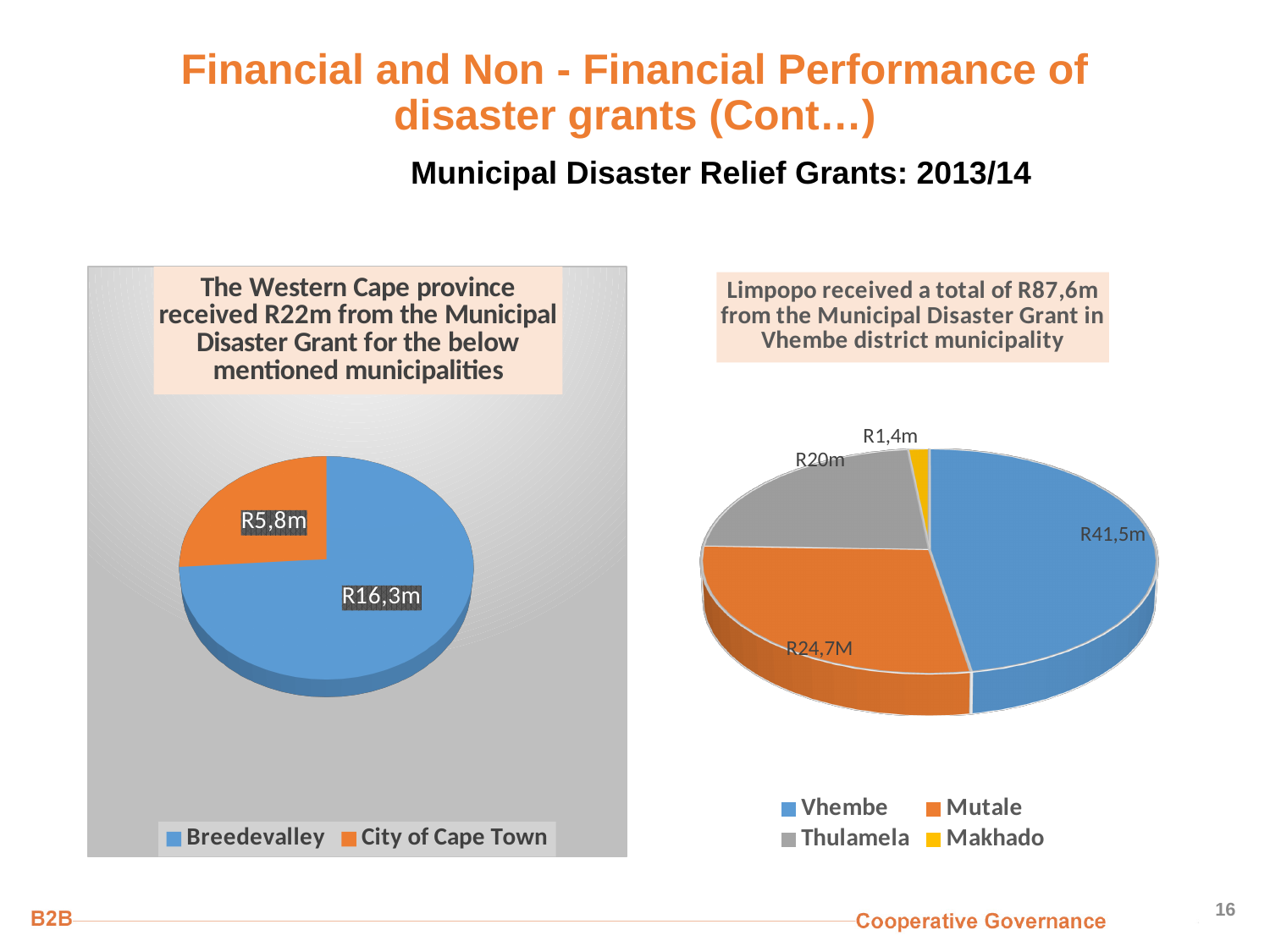
On the right chart (Limpopo), which colour represents Makhado in the legend? Yellow On the right chart (Limpopo), what value is shown for Vhembe? R41,5m On the right chart (Limpopo), which municipality received the largest amount? Vhembe On the left chart (Western Cape), what is the difference between the Breedevalley and City of Cape Town values? R10,5m On the right chart (Limpopo), what is the difference between the Vhembe and Mutale values? R16,8m On the left chart (Western Cape), what value is shown for Breedevalley? R16,3m What type of chart is the left chart (Western Cape)? Pie chart On the left chart (Western Cape), what value is shown for City of Cape Town? R5,8m On the right chart (Limpopo), which is larger, Mutale or Thulamela? Mutale On the right chart (Limpopo), what value is shown for Thulamela? R20m How many slices does the right chart (Limpopo) have? 4 On the right chart (Limpopo), which municipality received the smallest amount? Makhado